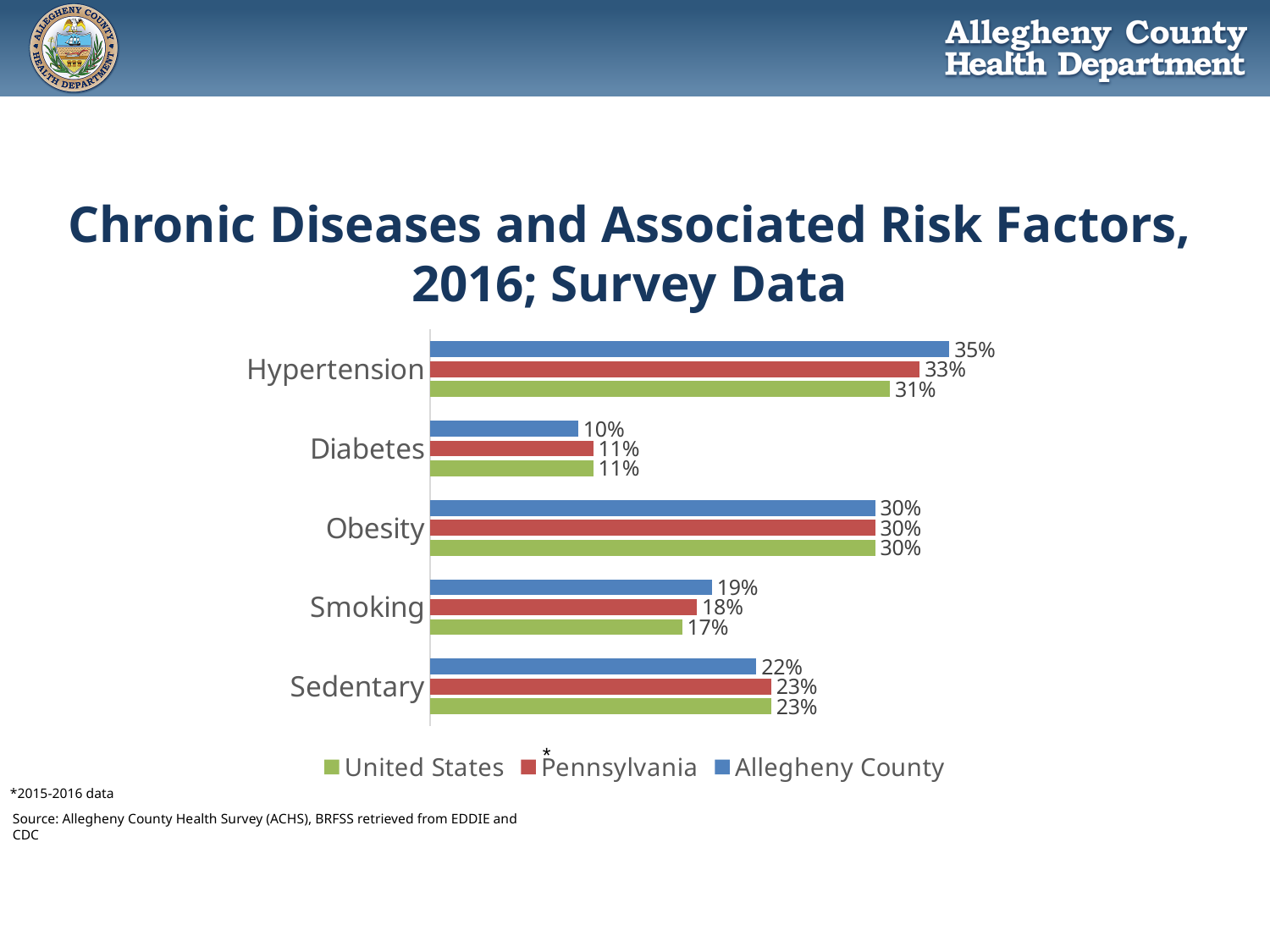
What kind of chart is shown on the slide? Bar chart What is the Pennsylvania value for Sedentary? 23% What is the difference between the Allegheny County and United States values for Hypertension? 4% How many categories are shown on the chart? 5 Which category has the highest Allegheny County value? Hypertension Which is larger for Smoking: the Allegheny County value or the United States value? Allegheny County Which series is shown in green in the legend? United States How many series does the legend list? 3 Which category has the lowest United States value? Diabetes What is the Allegheny County value for Hypertension? 35% What is the Allegheny County value for Diabetes? 10% What is the United States value for Smoking? 17%